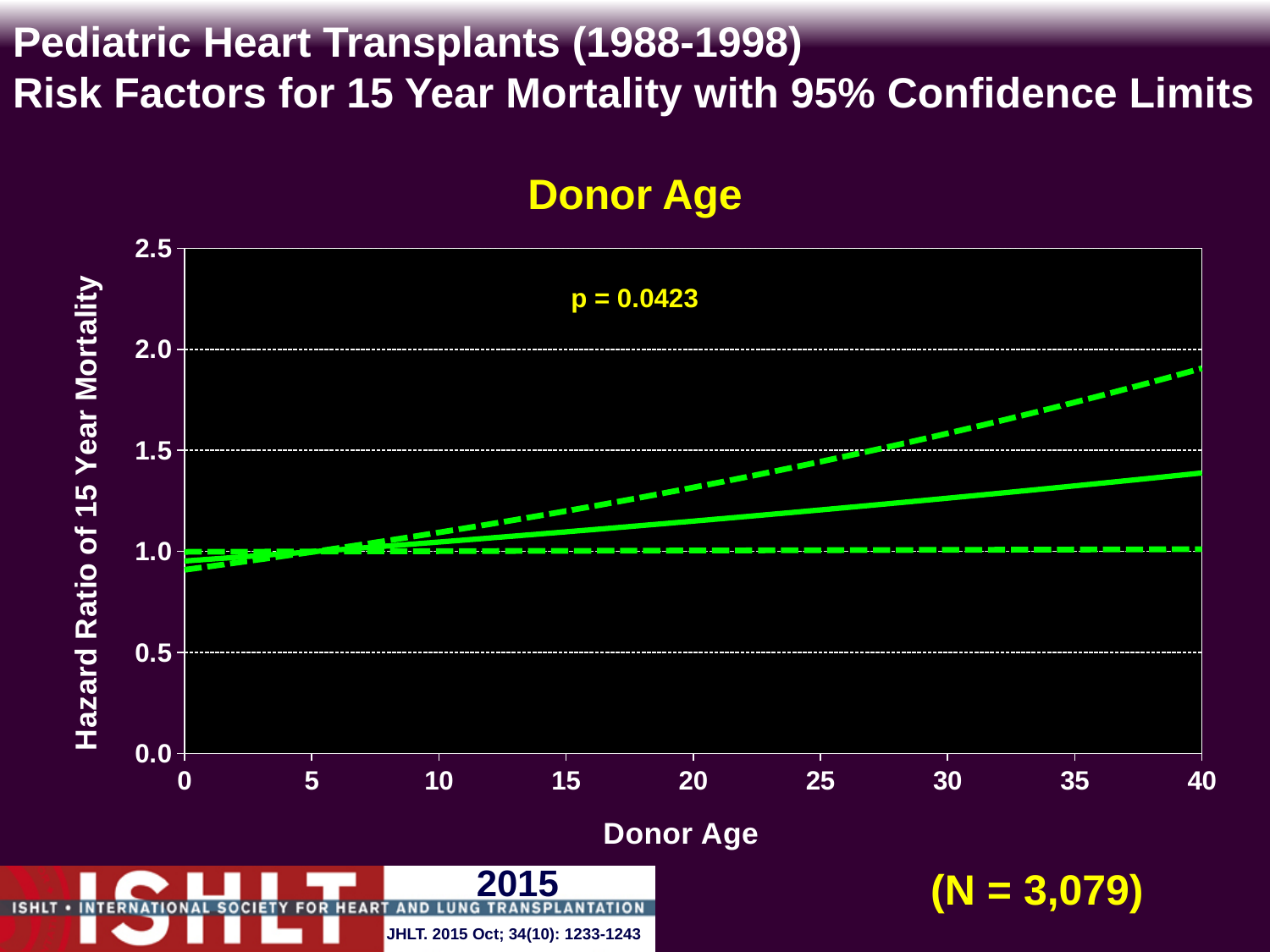
What is the sample size (N) shown on the slide? N = 3,079 Is the value of the upper dashed confidence limit at donor age 40 greater or less than 2.0? less What is the p-value printed on the chart? p = 0.0423 What is the maximum donor age shown on the x axis? 40 At donor age 40, which is larger: the solid hazard ratio line or the upper dashed confidence limit? the upper dashed confidence limit How many lines are plotted on the chart? 3 Is the value of the solid hazard ratio line at donor age 20 greater or less than 1.5? less Is the value of the solid hazard ratio line at donor age 40 greater or less than 1.0? greater What kind of chart is shown on the slide? line chart Does the solid line for hazard ratio rise or fall as donor age increases from 0 to 40? rise